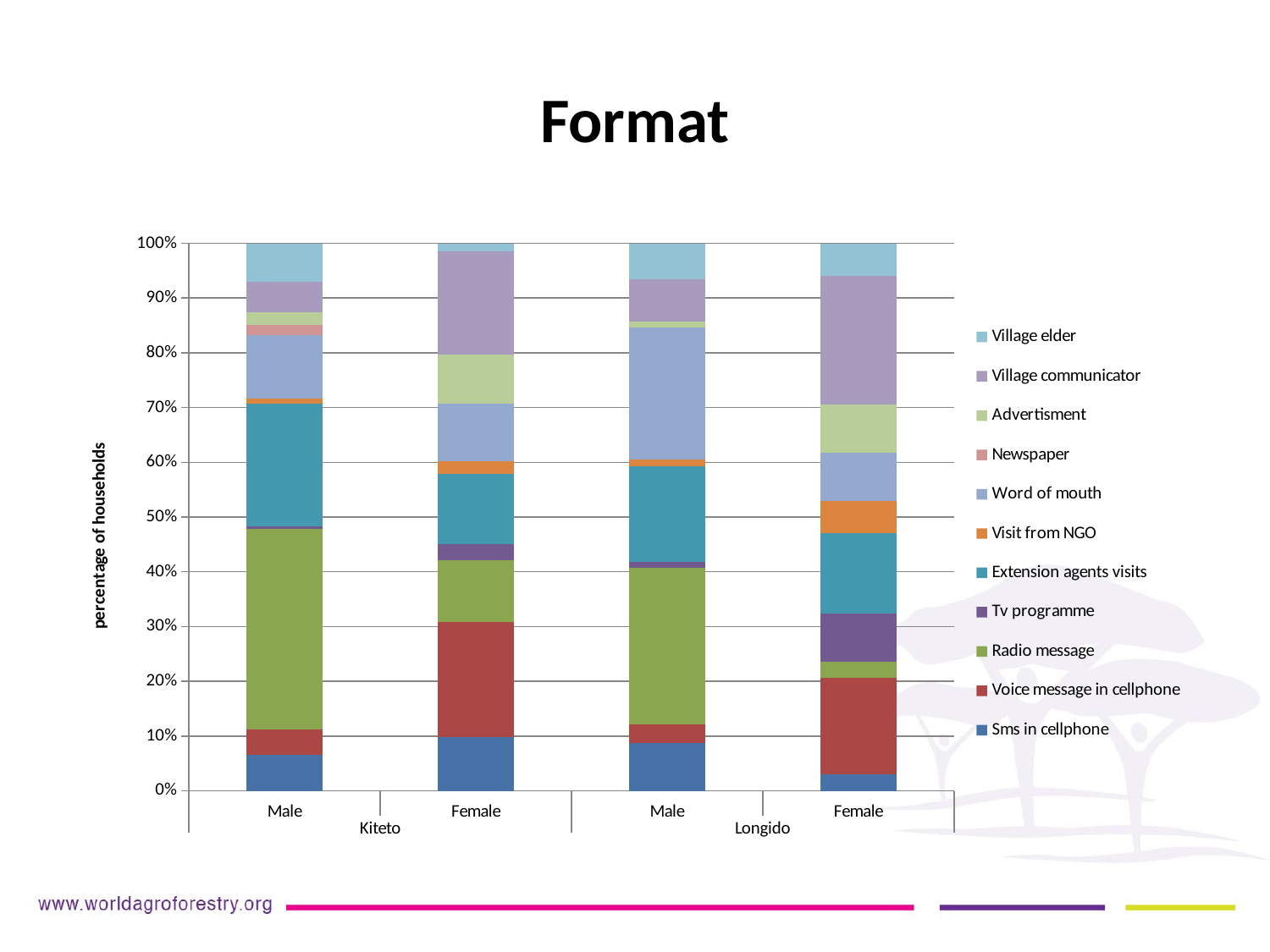
How many bars are plotted in the chart? 4 Which bar has the larger Village communicator segment, Kiteto Male or Kiteto Female? Kiteto Female Which bar has the larger Voice message in cellphone segment, Longido Male or Longido Female? Longido Female Is the Sms in cellphone segment for Longido Female greater or less than 10%? less Is the Radio message segment for Kiteto Male greater or less than 30%? greater What is the label on the vertical axis? percentage of households What is the total height of the Kiteto Male bar? 100% Which bar has the larger Radio message segment, Kiteto Male or Kiteto Female? Kiteto Male What kind of chart is shown on the slide? Stacked bar chart Is the Extension agents visits segment for Kiteto Male greater or less than 10%? greater How many series does the legend list? 11 What is the title of the slide? Format